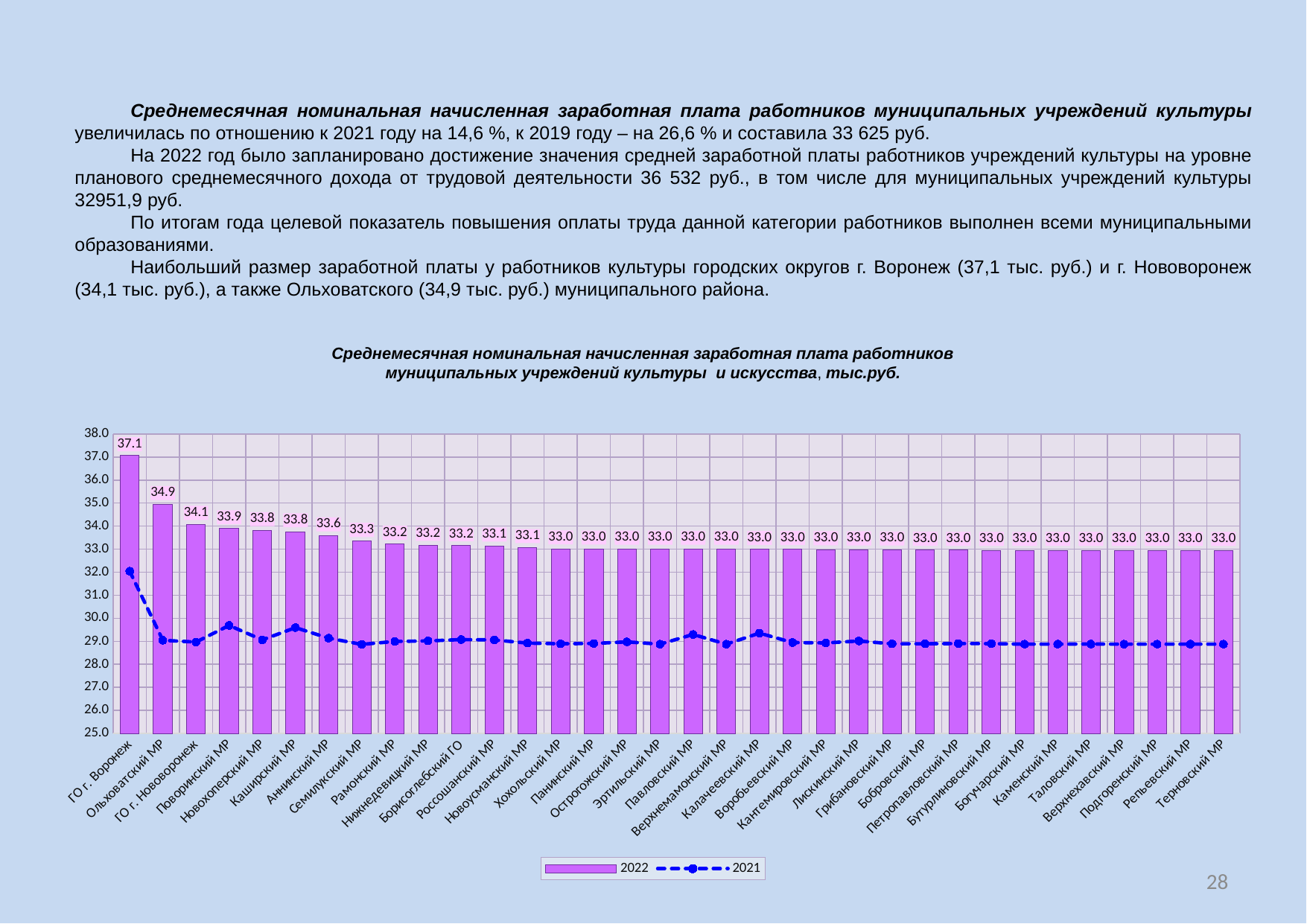
Do the 2022 values rise or fall from left to right along the x axis? fall How many categories are shown on the x axis? 34 What is the 2022 value for ГО г. Воронеж? 37.1 Is the 2021 value for Ольховатский МР greater or less than 30.0? less Which category has the highest 2022 value? ГО г. Воронеж Is the 2021 value for ГО г. Воронеж greater or less than 31.0? greater What is the difference between the 2022 values for ГО г. Воронеж and ГО г. Нововоронеж? 3.0 Which has the larger 2022 value, Ольховатский МР or Поворинский МР? Ольховатский МР How many series does the legend list? 2 What is the 2022 value for Аннинский МР? 33.6 What kind of chart is used for the 2022 series? bar chart What is the 2022 value for Ольховатский МР? 34.9